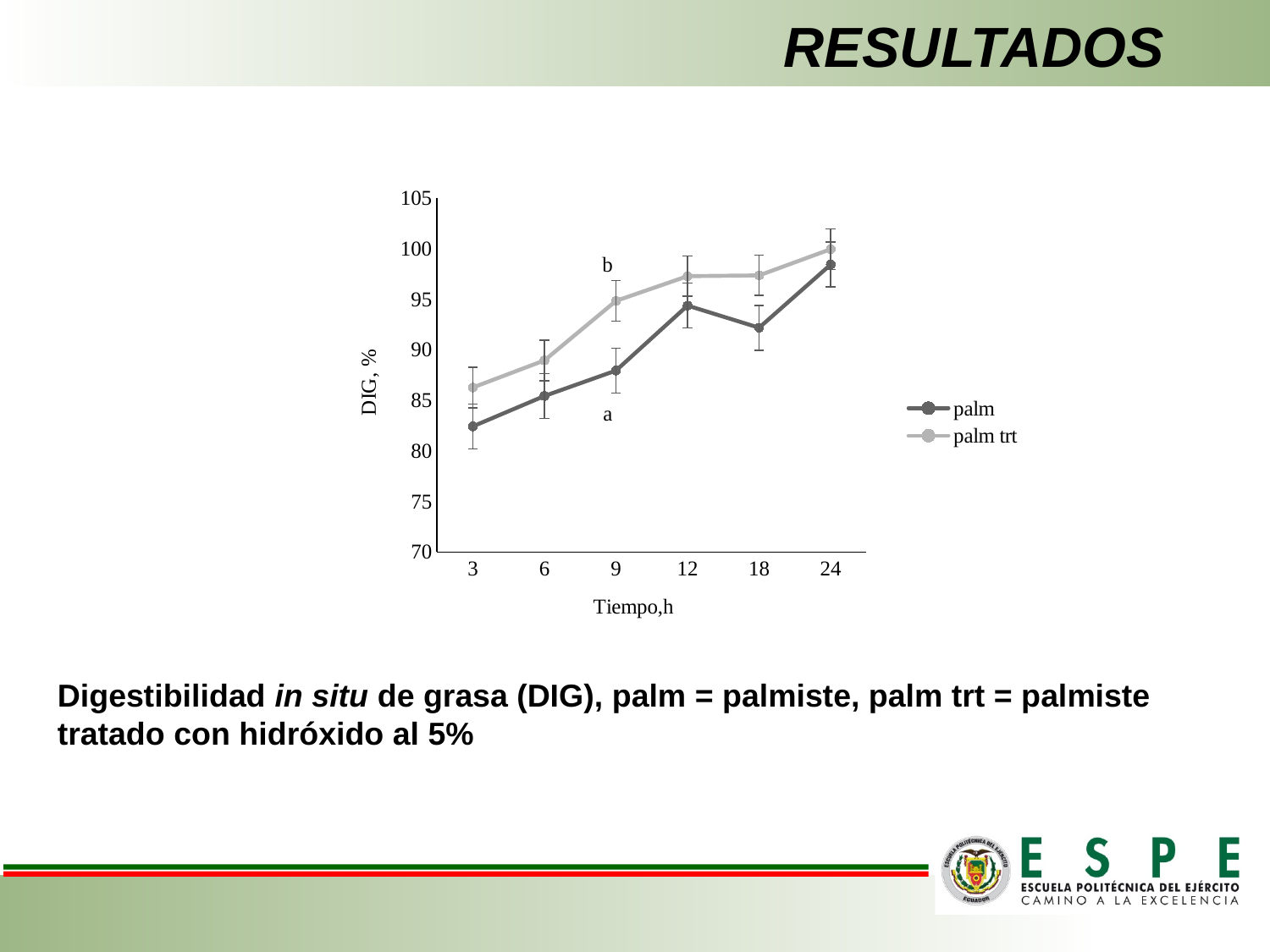
How many series does the legend list? 2 What is the label of the y axis? DIG, % At which time point does the palm series reach its lowest value? 3 What kind of chart is shown on the slide? line chart What is the label of the x axis? Tiempo,h Does the palm trt series rise or fall from 3 h to 24 h? rise At 9 h, which series has the higher value, palm or palm trt? palm trt Is the value for palm at 24 h greater or less than 95? greater Is the value for palm at 3 h greater or less than 85? less Is the value for palm trt at 12 h greater or less than 95? greater How many time points are plotted along the x axis? 6